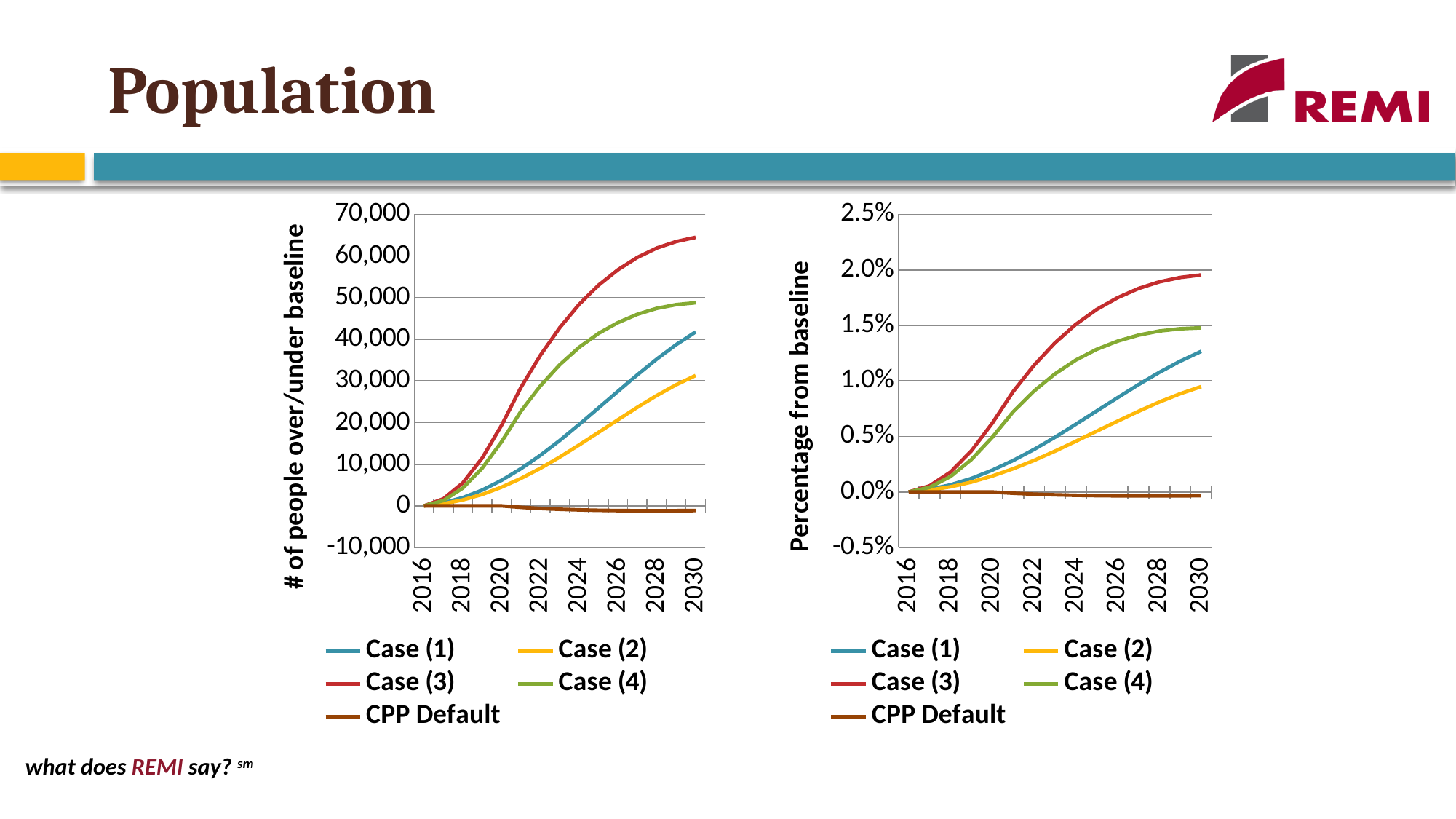
In the right chart (Percentage from baseline), which is larger in 2030: Case (4) or Case (1)? Case (4) What type of chart is the left chart on the slide? line chart In the left chart (# of people over/under baseline), is the value for Case (3) in 2030 greater or less than 60,000? greater How many series does the legend of the left chart list? 5 In the left chart (# of people over/under baseline), is the value for CPP Default in 2030 greater or less than 10,000? less In the right chart (Percentage from baseline), does the Case (3) line rise or fall from 2016 to 2030? rise In the left chart (# of people over/under baseline), which series has the lowest value in 2030? CPP Default In the right chart (Percentage from baseline), which series has the highest value in 2030? Case (3) In the left chart (# of people over/under baseline), which series has the highest value in 2030? Case (3) In the right chart (Percentage from baseline), is the value for Case (3) in 2030 greater or less than 1.5%? greater